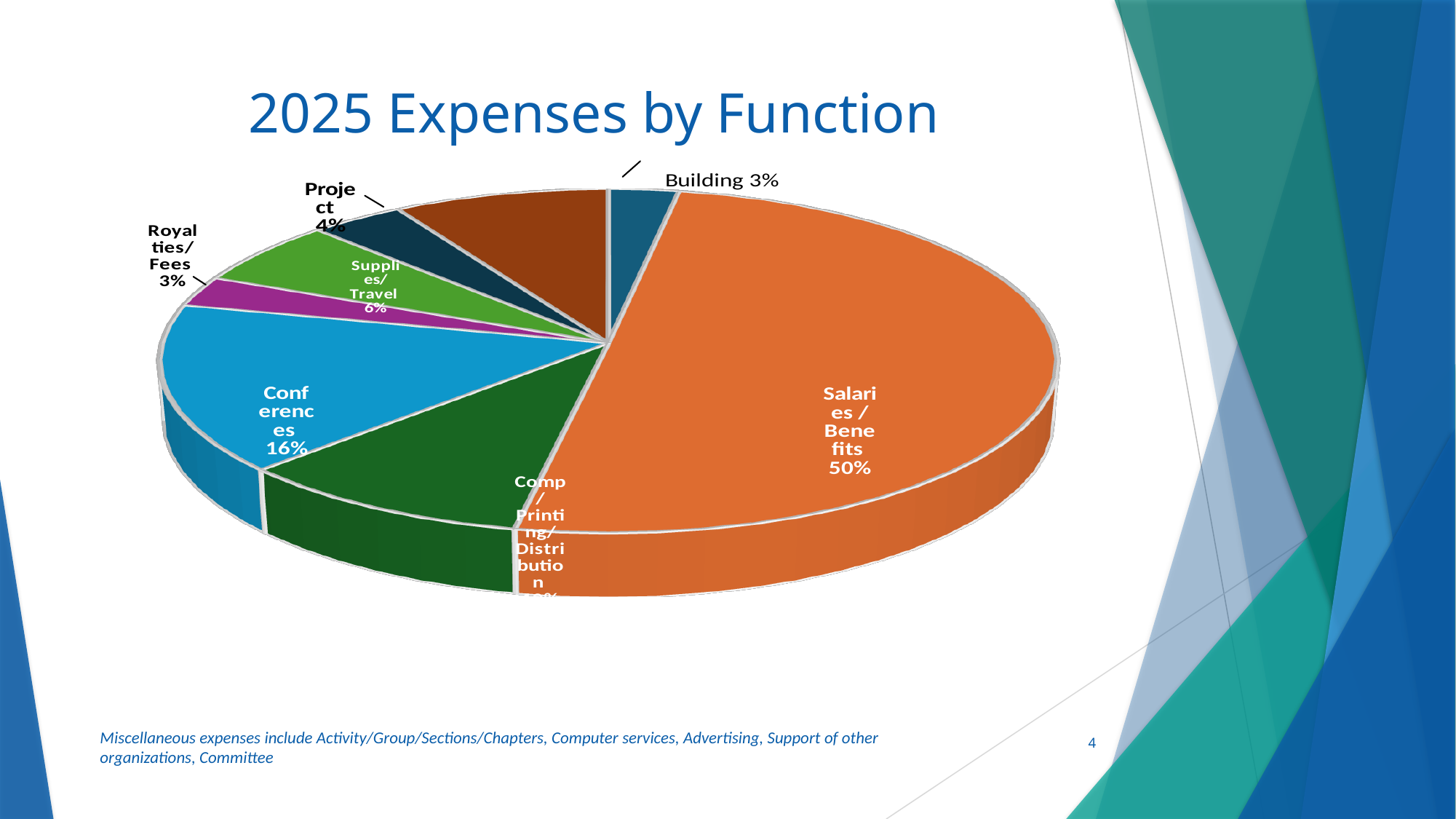
How many percentage points larger is the Salaries / Benefits share than the Conferences share? 34 percentage points How many slices does the pie chart have? 8 What share of expenses is Building? 3% Which expense category has the largest share of the pie? Salaries / Benefits Which is larger, the share for Conferences or the share for Supplies/Travel? Conferences What share of expenses is Project? 4% What share of expenses is Salaries / Benefits? 50% What kind of chart is shown on the slide? Pie chart What share of expenses is Conferences? 16% What share of expenses is Supplies/Travel? 6% What is the title of the chart? 2025 Expenses by Function What share of expenses is Royalties/Fees? 3%